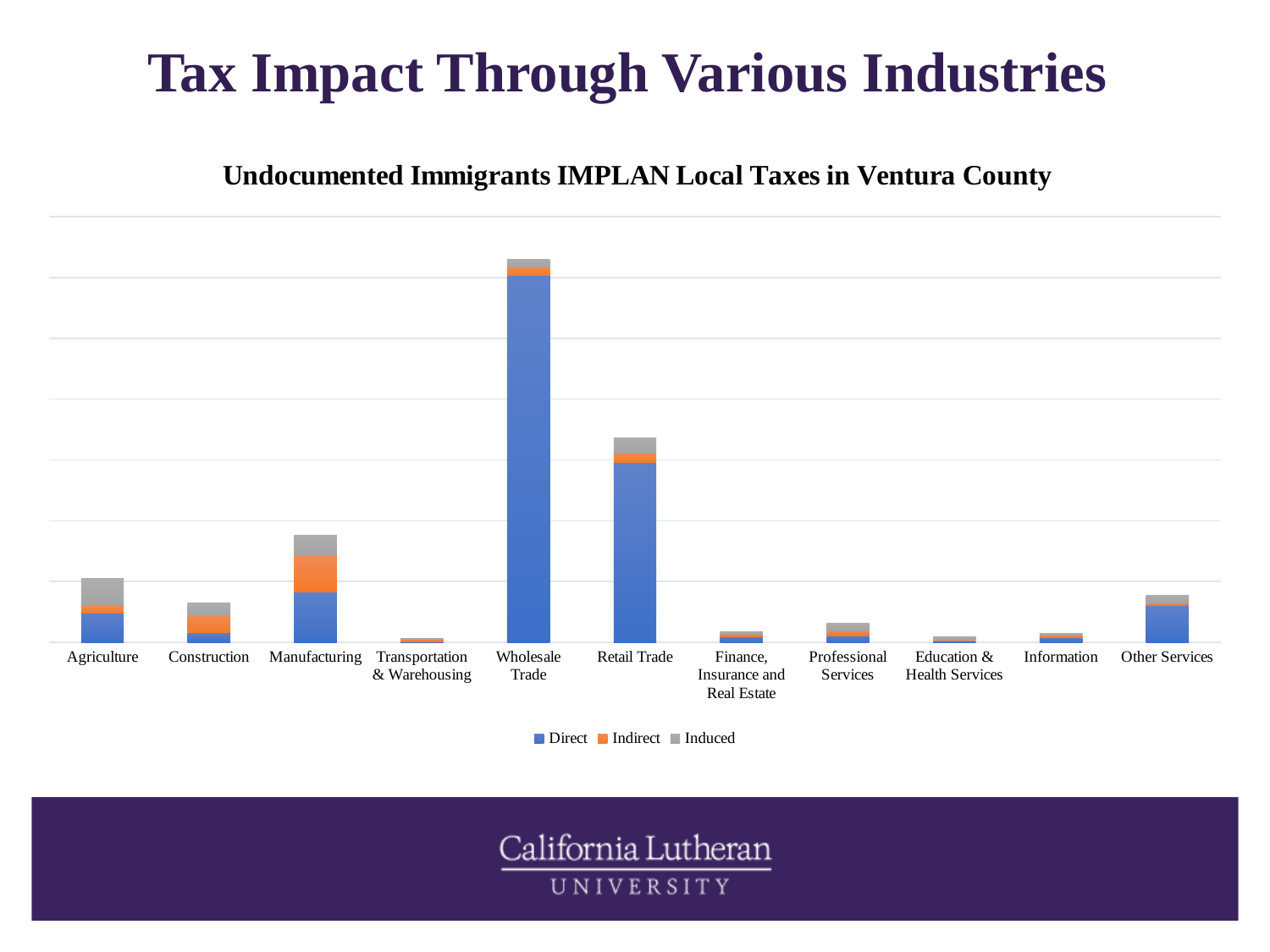
Which has a larger total bar, Retail Trade or Manufacturing? Retail Trade Which has a larger total bar, Agriculture or Construction? Agriculture In the Wholesale Trade bar, which series makes up the largest portion? Direct How many industry categories are shown on the x axis? 11 Which industry has the highest total local taxes? Wholesale Trade How many series does the legend list? 3 Which series are listed in the legend? Direct, Indirect, Induced What type of chart is shown on the slide? Stacked bar chart Which industry has the second highest total bar? Retail Trade What is the title of the chart? Undocumented Immigrants IMPLAN Local Taxes in Ventura County Which industry has the lowest total local taxes? Transportation & Warehousing